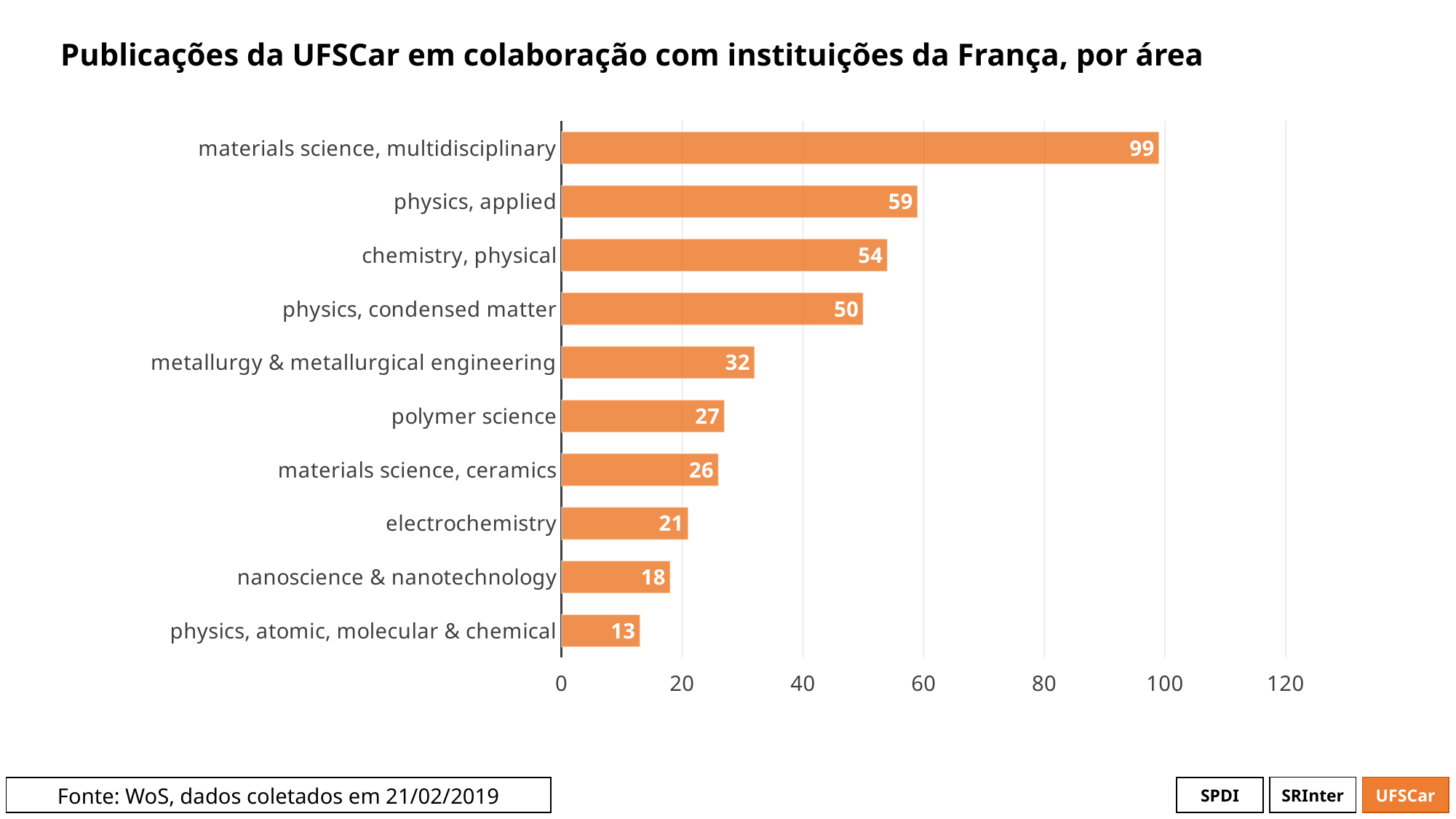
What is the value for materials science, multidisciplinary? 99 What is the difference between the values for physics, applied and chemistry, physical? 5 What is the title of the chart? Publicações da UFSCar em colaboração com instituições da França, por área Is the value for physics, condensed matter greater or less than 40? greater Which is larger, the value for metallurgy & metallurgical engineering or the value for polymer science? metallurgy & metallurgical engineering Which area has the lowest number of publications? physics, atomic, molecular & chemical What is the value for physics, condensed matter? 50 How many areas are shown in the chart? 10 Which area has the highest number of publications? materials science, multidisciplinary What is the value for electrochemistry? 21 What kind of chart is shown on the slide? bar chart What is the difference between the values for materials science, multidisciplinary and nanoscience & nanotechnology? 81